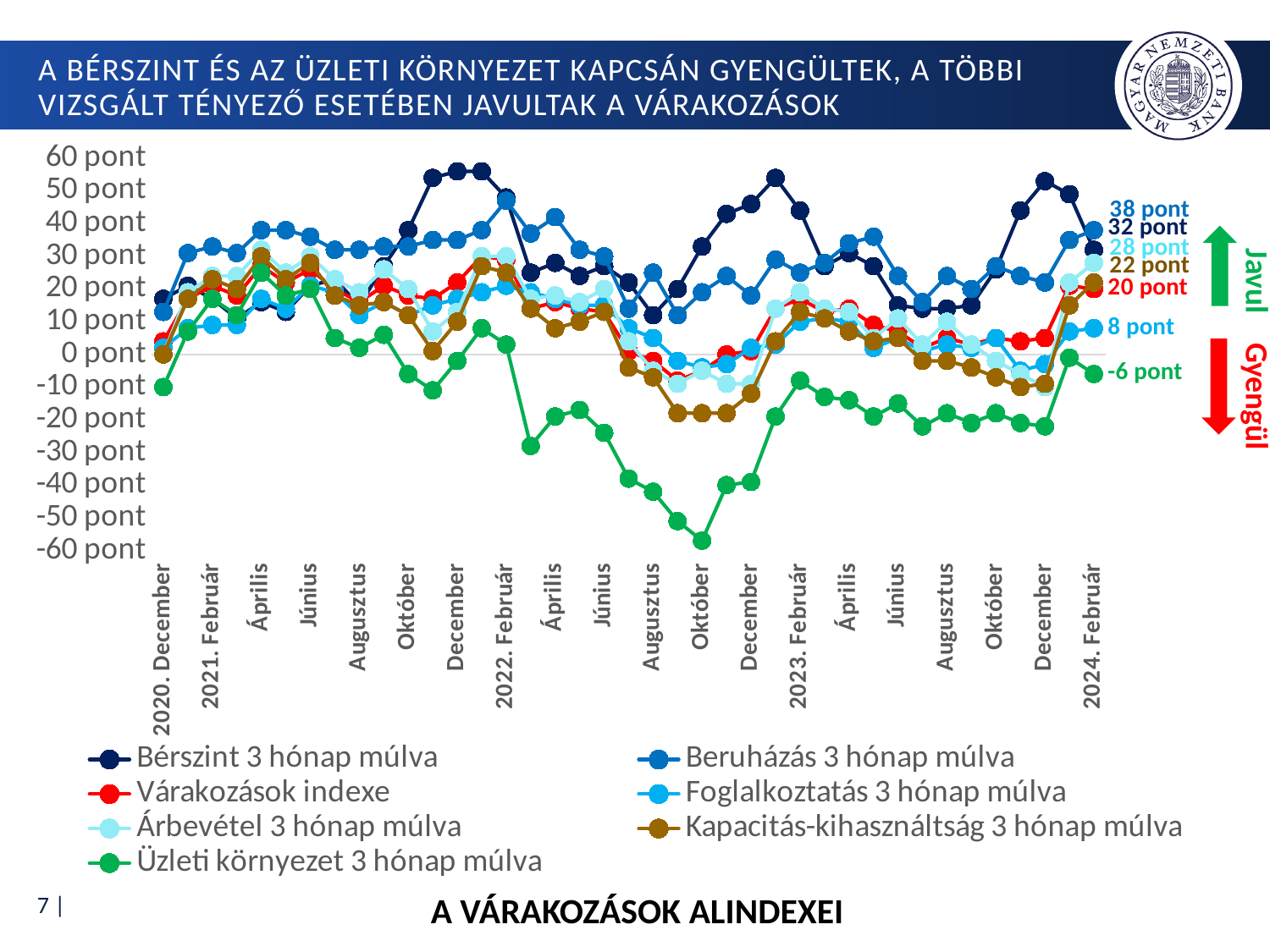
What kind of chart is shown on the slide? Line chart Is the value for Bérszint 3 hónap múlva in 2021 December greater or less than 50 pont? greater At 2024. Február, which is larger: Bérszint 3 hónap múlva or Árbevétel 3 hónap múlva? Bérszint 3 hónap múlva Which series has the highest value at 2024. Február? Beruházás 3 hónap múlva Is the value for Üzleti környezet 3 hónap múlva in 2022 Október greater or less than -50 pont? less What is the value of Üzleti környezet 3 hónap múlva at 2024. Február? -6 pont Which series has the lowest value at 2024. Február? Üzleti környezet 3 hónap múlva What is the value of Várakozások indexe at 2024. Február? 20 pont How many series does the legend list? 7 What is the difference between the Beruházás 3 hónap múlva and Üzleti környezet 3 hónap múlva values at 2024. Február? 44 pont What is the title of the chart? A VÁRAKOZÁSOK ALINDEXEI What is the value of Beruházás 3 hónap múlva at 2024. Február? 38 pont